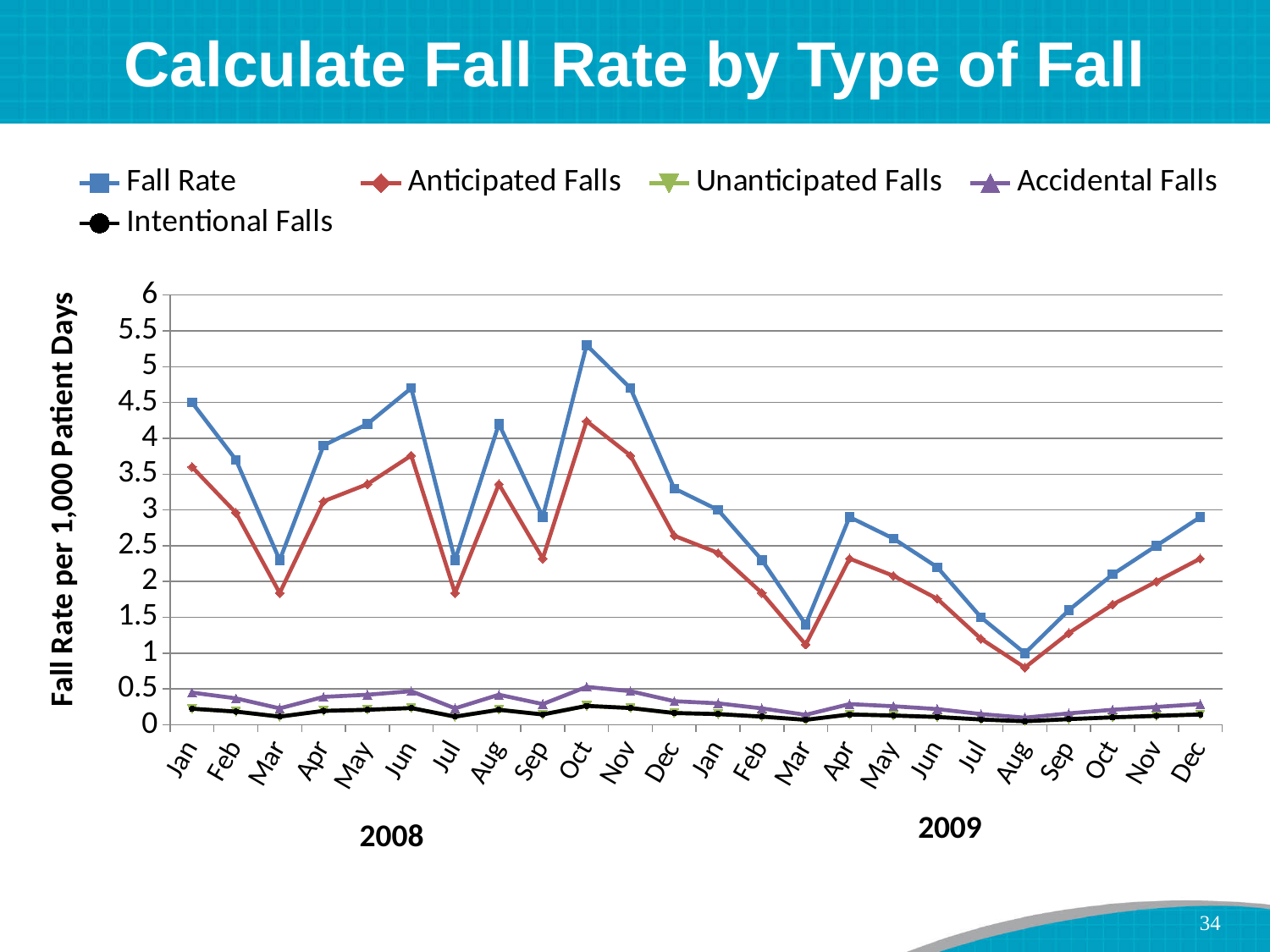
In which month is the Fall Rate lowest? Aug 2009 Is the Fall Rate for Mar 2008 greater or less than 2.5? less Which series has higher values throughout the chart, Anticipated Falls or Accidental Falls? Anticipated Falls Is the Fall Rate for Oct 2008 greater or less than 5? greater Overall, does the Fall Rate rise or fall from Jan 2008 to Dec 2009? fall Which is larger, the Fall Rate in Oct 2008 or the Fall Rate in Mar 2009? Oct 2008 How many monthly data points are plotted along the x axis? 24 What kind of chart is shown on the slide? line chart What is the label on the vertical axis? Fall Rate per 1,000 Patient Days In which month is the Fall Rate highest? Oct 2008 Is the Anticipated Falls value for Mar 2009 greater or less than 1.5? less How many series does the legend list? 5